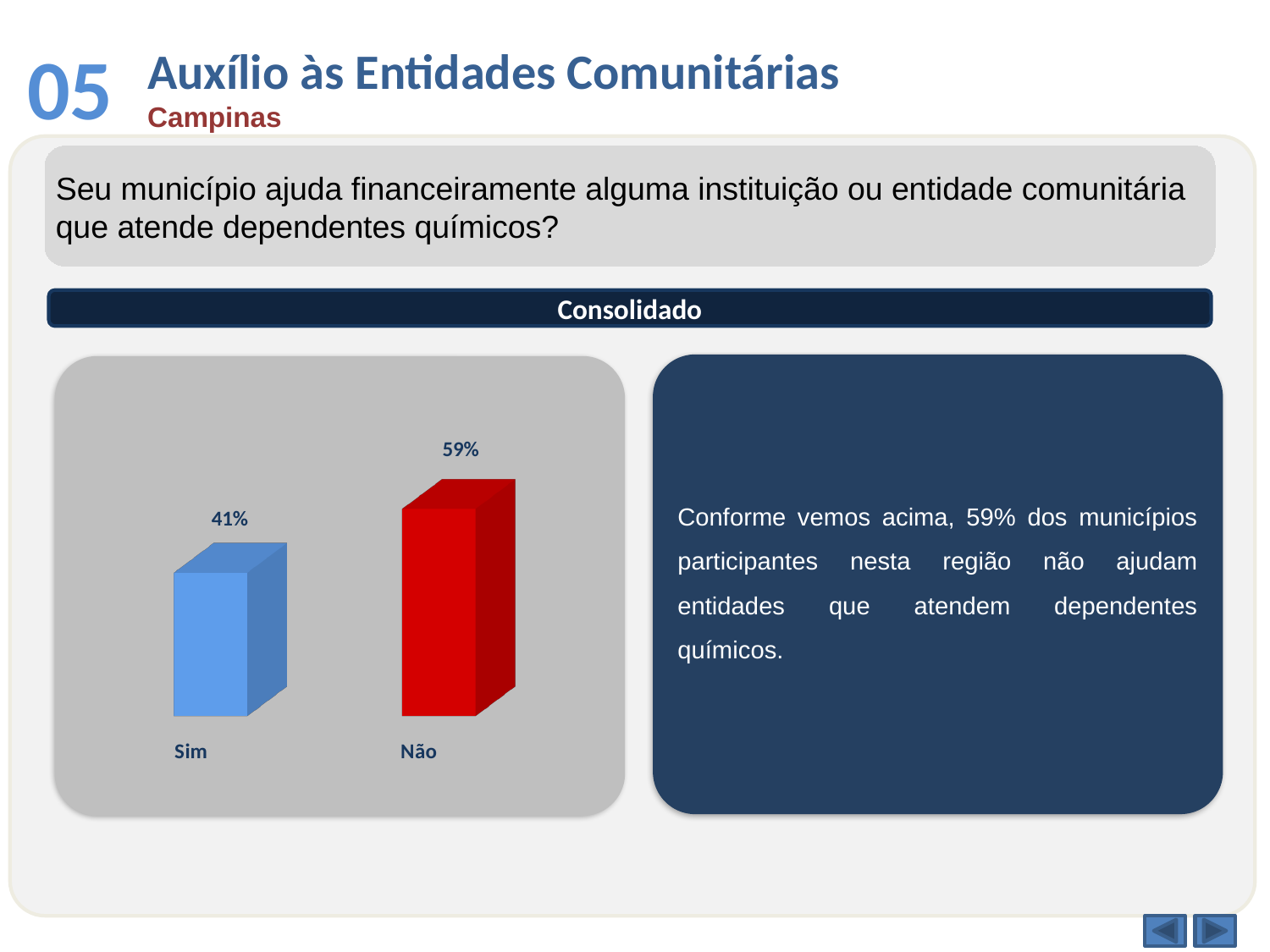
What is the total of the two values shown in the chart? 100% What is the value for "Sim" in the chart? 41% What colour is the bar for "Sim"? Blue Which category has the lowest value in the chart? Sim How many categories are shown in the chart? 2 Which is larger, the value for "Sim" or the value for "Não"? Não What is the difference between the values for "Não" and "Sim"? 18% What is the value for "Não" in the chart? 59% What kind of chart is shown on the slide? Bar chart What colour is the bar for "Não"? Red Which category has the highest value in the chart? Não